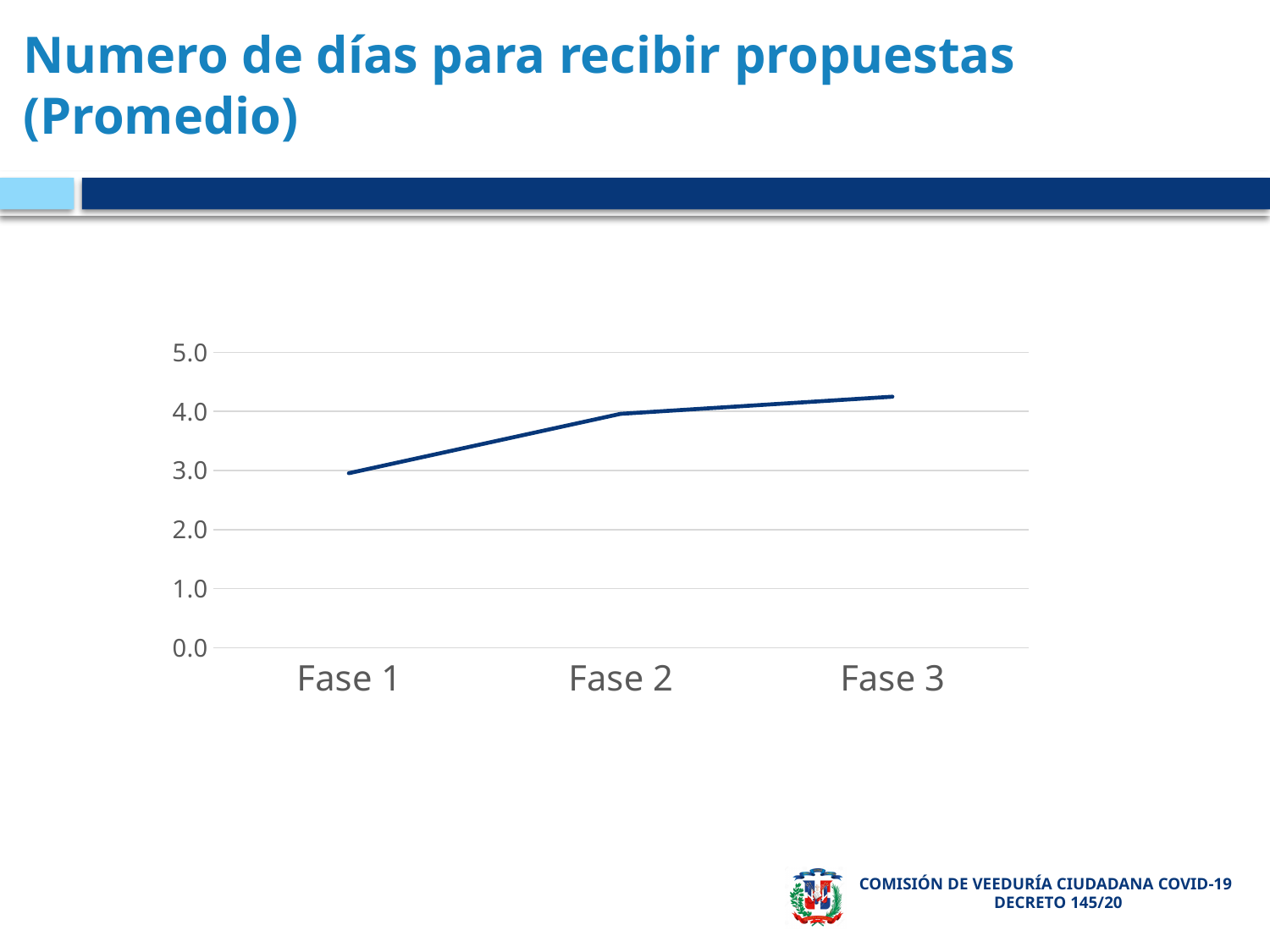
What is the highest value shown on the y axis? 5.0 Is the value for Fase 2 greater or less than 3.0? greater Which is larger, the value for Fase 2 or the value for Fase 3? Fase 3 Which phase has the lowest average number of days to receive proposals? Fase 1 Is the value for Fase 3 greater or less than 5.0? less What is the title of the slide containing the chart? Numero de días para recibir propuestas (Promedio) Is the value for Fase 1 greater or less than 2.0? greater How many phases (categories) are plotted on the x axis? 3 Which is larger, the value for Fase 1 or the value for Fase 2? Fase 2 Do the values rise or fall from Fase 1 to Fase 3? rise Which phase has the highest average number of days to receive proposals? Fase 3 What kind of chart is shown on the slide? line chart